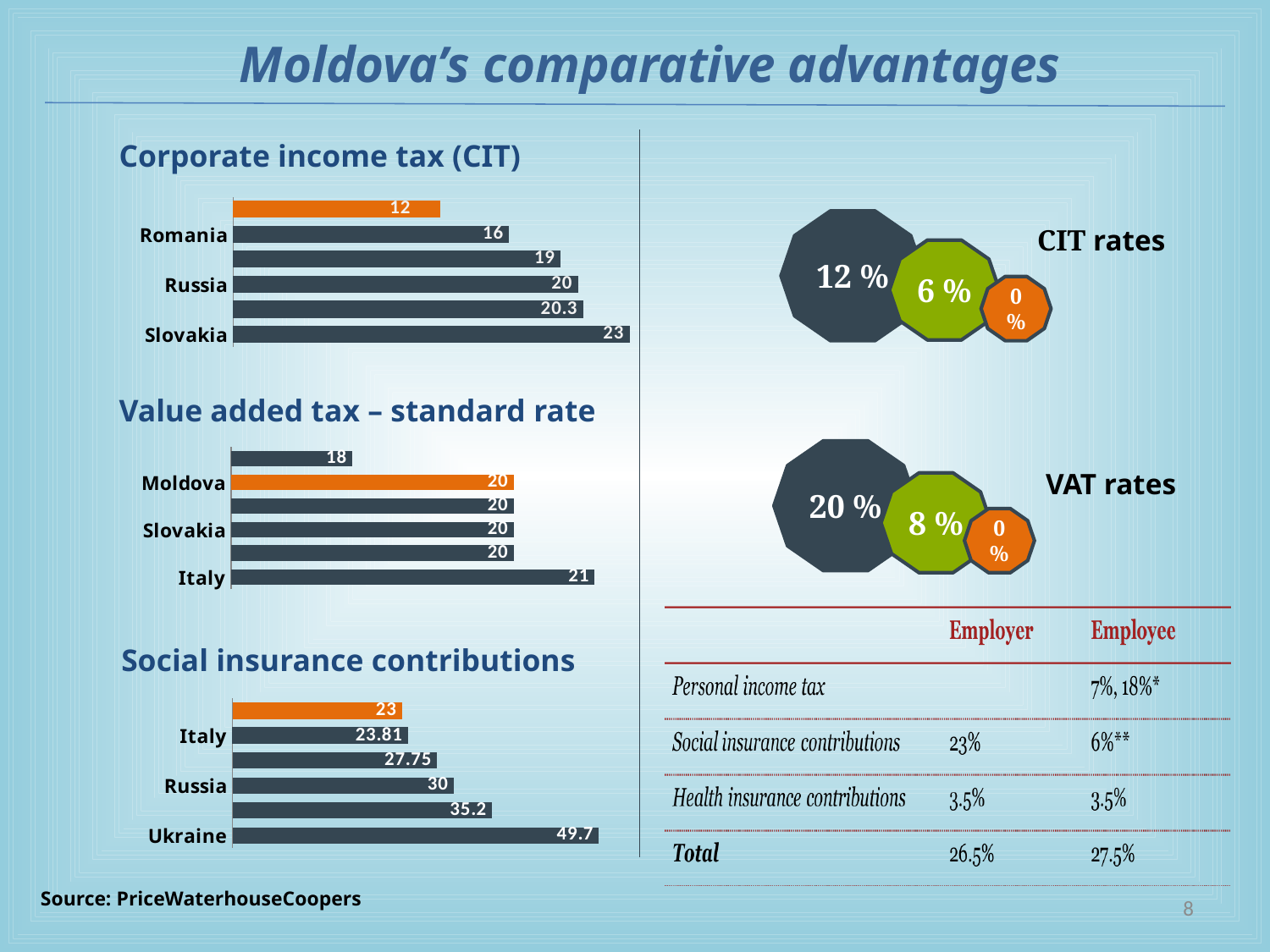
In the Value added tax – standard rate chart, what is the value for Italy? 21 In the Social insurance contributions chart, what is the difference between Ukraine and Russia? 19.7 In the Value added tax – standard rate chart, what is the value for Moldova? 20 In the Social insurance contributions chart, what is the value for Italy? 23.81 In the Corporate income tax (CIT) chart, what is the value for Romania? 16 In the Corporate income tax (CIT) chart, which labelled country has the highest value? Slovakia In the Corporate income tax (CIT) chart, what is the difference between Slovakia and Russia? 3 What type of chart is the Social insurance contributions chart? Bar chart In the Social insurance contributions chart, what is the value for Ukraine? 49.7 In the Corporate income tax (CIT) chart, what is the value for Slovakia? 23 In the Value added tax – standard rate chart, which is larger, Italy or Slovakia? Italy In the Corporate income tax (CIT) chart, how many bars are plotted? 6